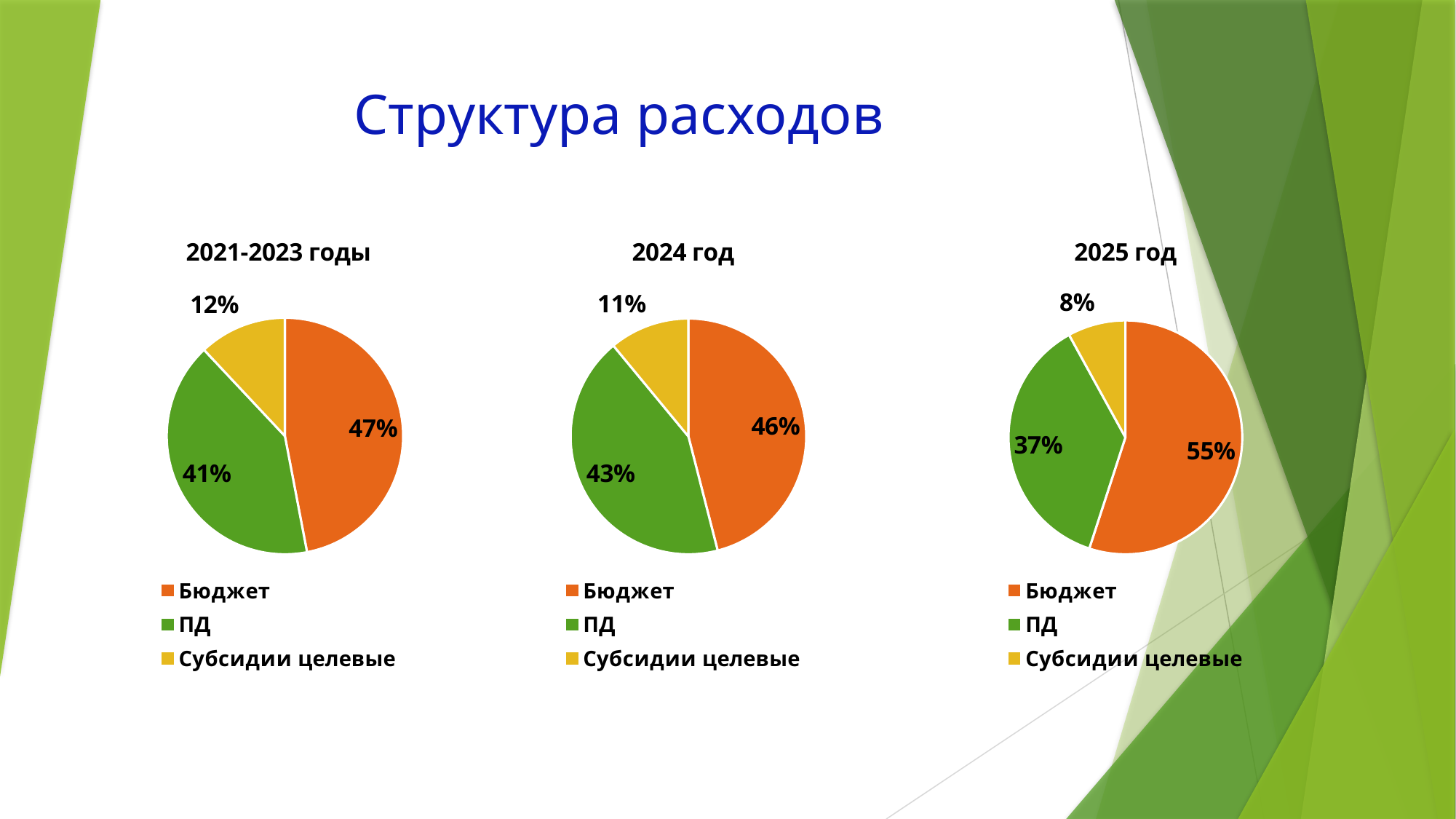
In the '2021-2023 годы' chart, which category has the smallest slice? Субсидии целевые What kind of chart is the '2021-2023 годы' chart? Pie chart In the '2025 год' chart, which category has the largest slice? Бюджет In the '2024 год' chart, which is larger: Бюджет or ПД? Бюджет In the '2021-2023 годы' chart, what share does Бюджет have? 47% How many slices does the '2024 год' chart have? 3 In the '2021-2023 годы' chart, what is the difference between the ПД and Субсидии целевые shares? 29% How many entries does the legend of the '2025 год' chart list? 3 In the '2025 год' chart, what is the difference between the Бюджет and ПД shares? 18% In the '2025 год' chart, what share does Субсидии целевые have? 8% What is the title of the slide containing the three pie charts? Структура расходов In the '2024 год' chart, what share does ПД have? 43%